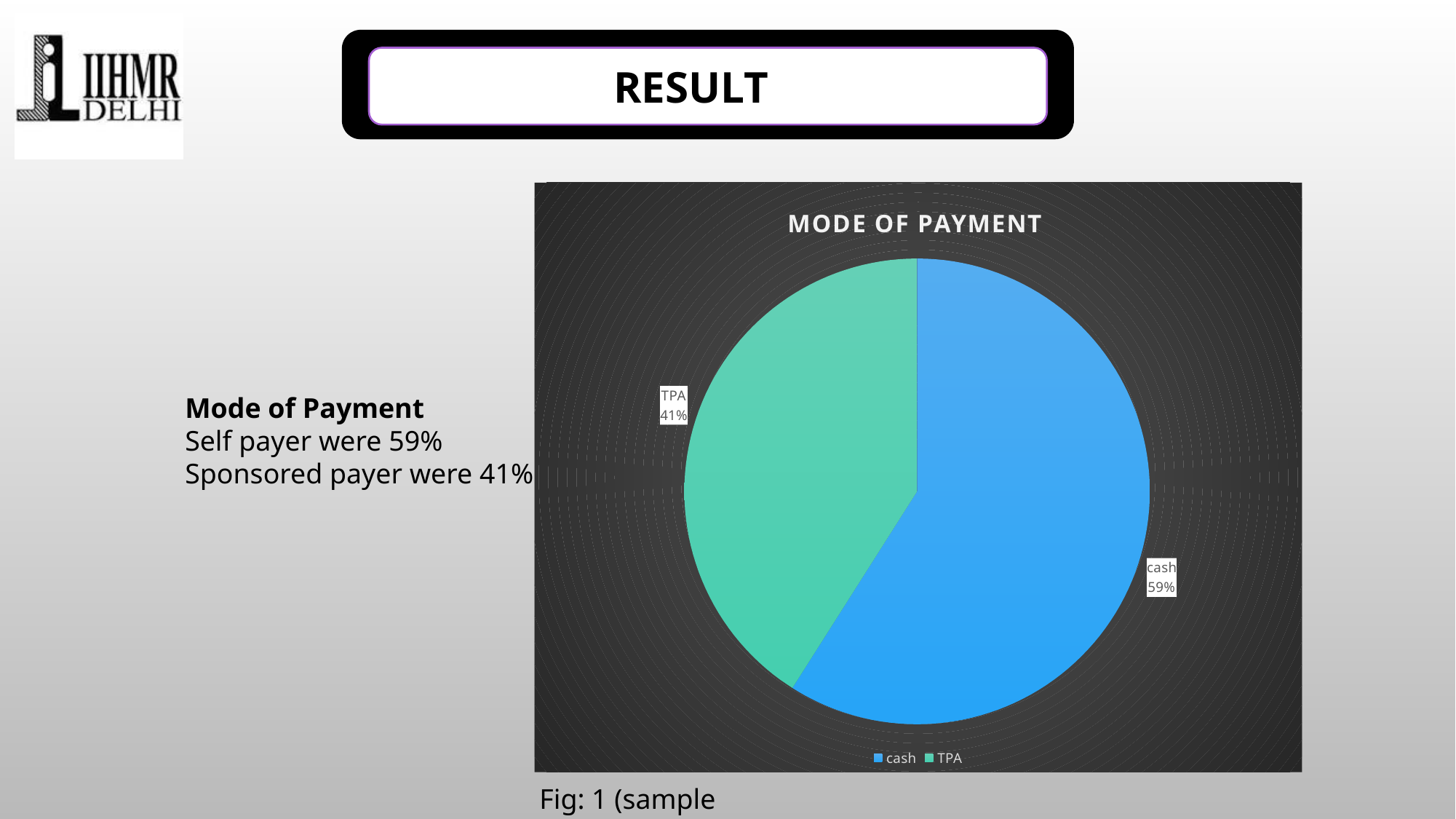
Which mode of payment has the largest share of the pie? cash How many slices does the pie chart have? 2 What is the title of the chart? MODE OF PAYMENT Which slice is larger, cash or TPA? cash Which mode of payment has the smallest share of the pie? TPA What share of the pie does the TPA slice represent? 41% What colour is the TPA slice in the pie chart? green What is the difference in percentage points between the cash and TPA shares? 18% What kind of chart is shown on the slide? pie chart Is the share for cash greater or less than 50%? greater What share of the pie does the cash slice represent? 59% How many entries does the legend list? 2